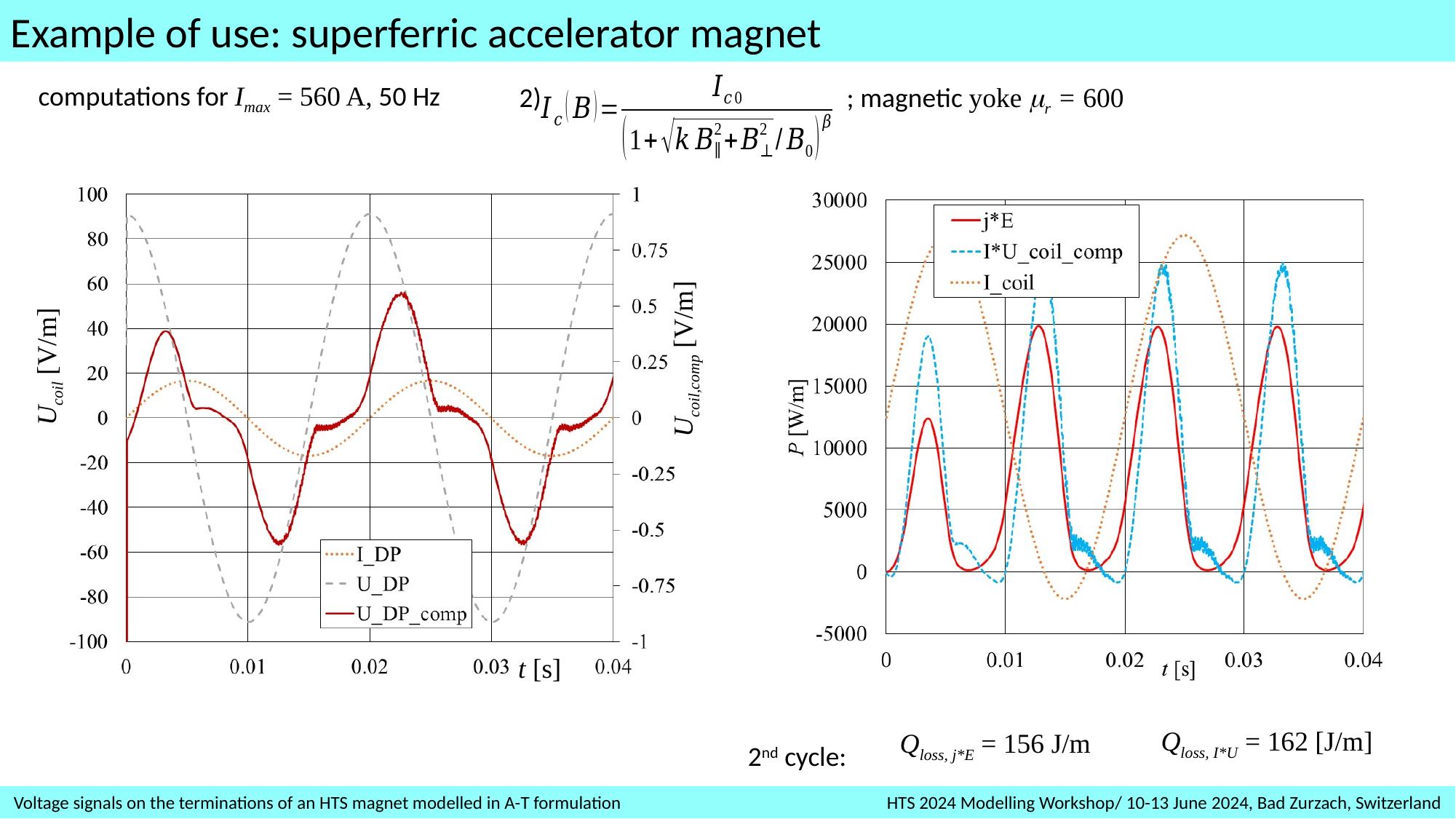
What kind of chart is the right chart (P vs t)? line chart On the left chart, is the peak value of U_DP near t = 0.02 s greater or less than 80 on the left axis? greater On the left chart, is the peak value of U_DP_comp near t = 0.0225 s greater or less than 40 on the left axis? greater On the right chart, is the first peak of j*E near t = 0.003 s greater or less than 15000? less What kind of chart is the left chart (U_coil vs t)? line chart On the right chart, near t = 0.023 s, which peak is higher: j*E or I*U_coil_comp? I*U_coil_comp What are the legend entries of the left chart? I_DP, U_DP, U_DP_comp How many series does the legend of the left chart list? 3 How many series does the legend of the right chart (P vs t) list? 3 What is the label of the right-hand vertical axis of the left chart? U_coil,comp [V/m]